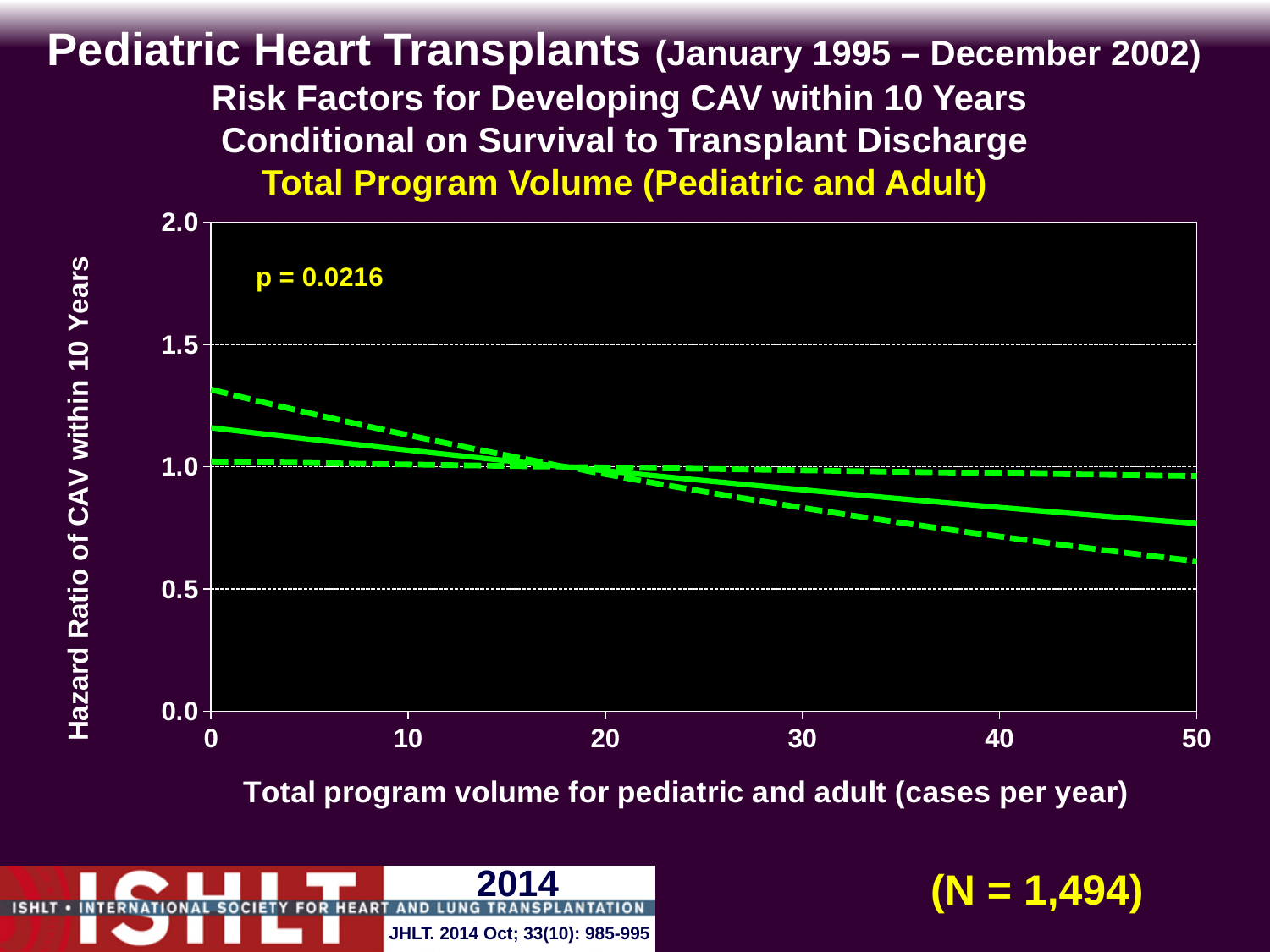
Is the lower dashed line at a program volume of 50 cases per year greater or less than 0.5? greater Is the solid hazard ratio line at a program volume of 0 cases per year greater or less than 1.5? less Is the solid hazard ratio line higher at a program volume of 0 or at 50 cases per year? 0 Does the solid hazard ratio line rise or fall as total program volume increases from 0 to 50 cases per year? fall What is the highest value shown on the y axis of the chart? 2.0 Is the upper dashed line at a program volume of 0 cases per year greater or less than 1.0? greater How many lines are plotted on the chart? 3 What kind of chart is shown on the slide? line chart What p-value is printed on the chart? p = 0.0216